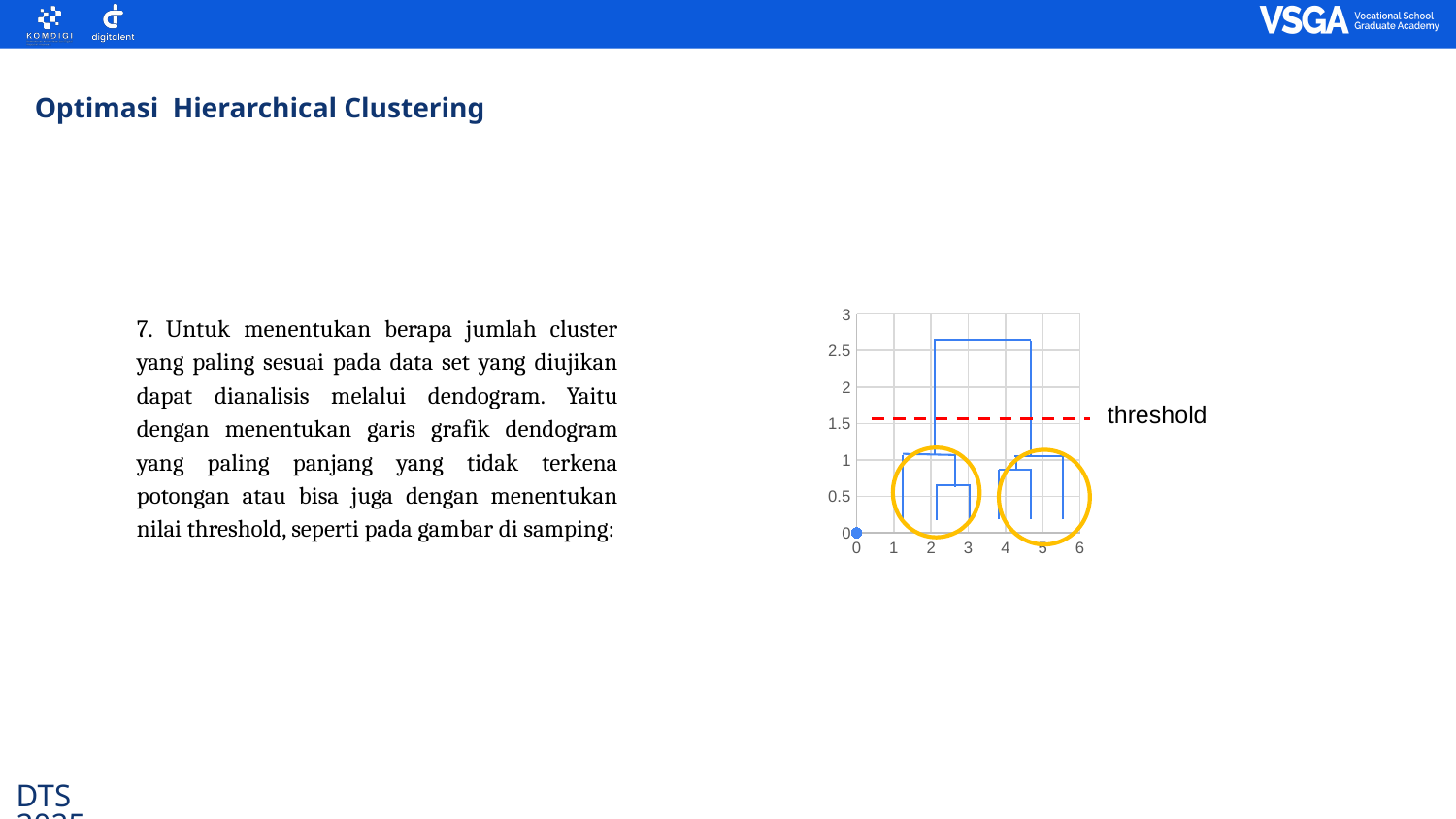
What label is written next to the red dashed line? threshold What colour are the dendrogram lines? blue Is the red dashed threshold line drawn at a value greater or less than 2? less Is the height of the topmost merge in the dendrogram greater or less than 2.5? greater What is the maximum value shown on the y-axis of the dendrogram? 3 What kind of chart is shown on the slide? dendrogram Is the topmost merge of the dendrogram above or below the threshold line? above How many leaf points (vertical lines reaching 0) does the dendrogram have? 6 Is the height of the topmost merge in the dendrogram greater or less than 3? less What is the maximum value shown on the x-axis of the dendrogram? 6 How many clusters are circled in yellow on the dendrogram? 2